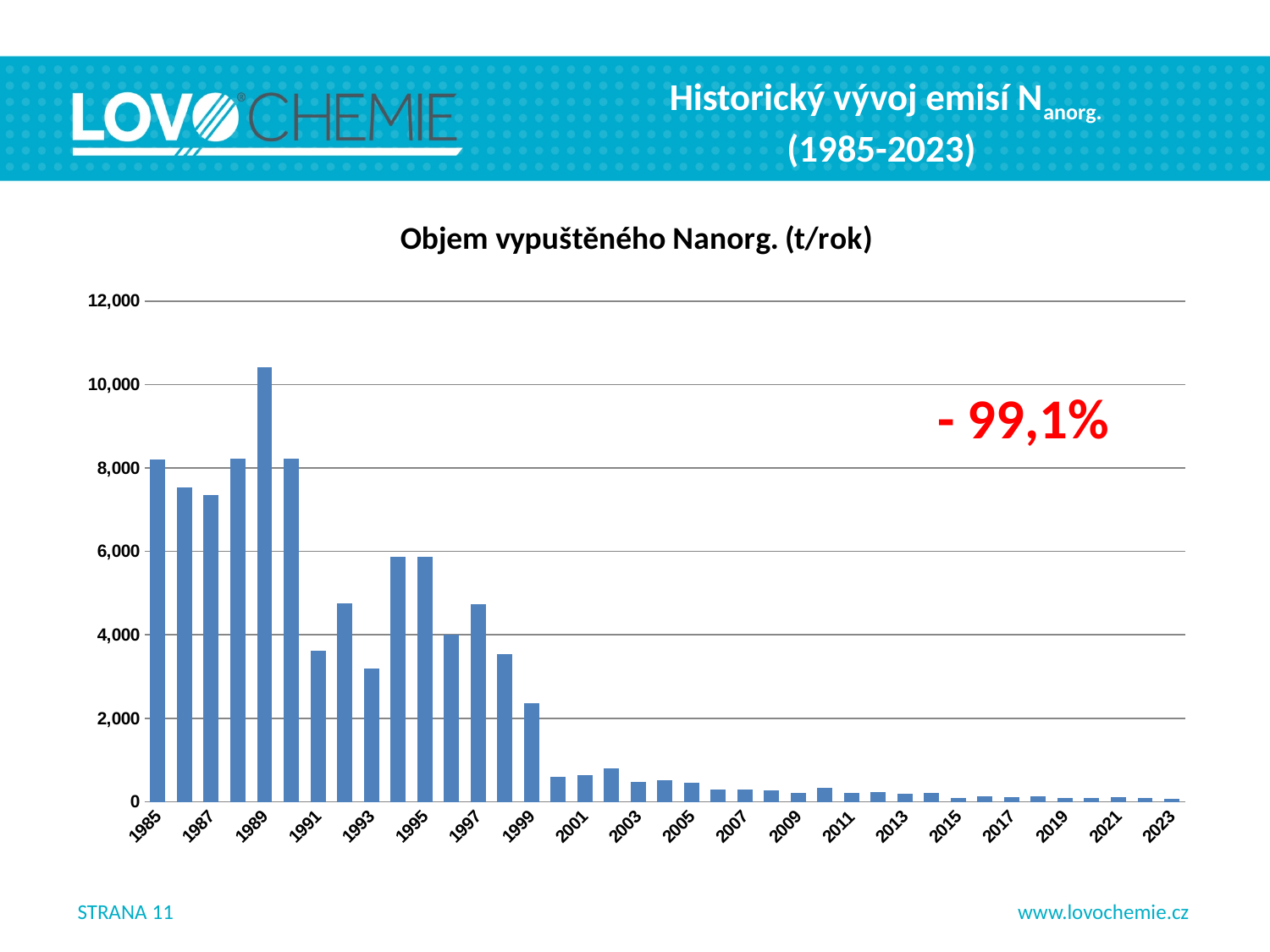
Is the value for 1999 greater or less than 2,000? greater Which year has the larger value, 1995 or 1997? 1995 Is the value for 2001 greater or less than 2,000? less Which year has the highest value in the chart? 1989 What percentage change is annotated in red on the chart? - 99,1% How many years (bars) are plotted in the chart? 39 What is the title of the chart? Objem vypuštěného Nanorg. (t/rok) Is the value for 1991 greater or less than 4,000? less Which year has the larger value, 1985 or 1987? 1985 What kind of chart is shown on the slide? bar chart Do the values generally rise or fall from 1985 to 2023? fall